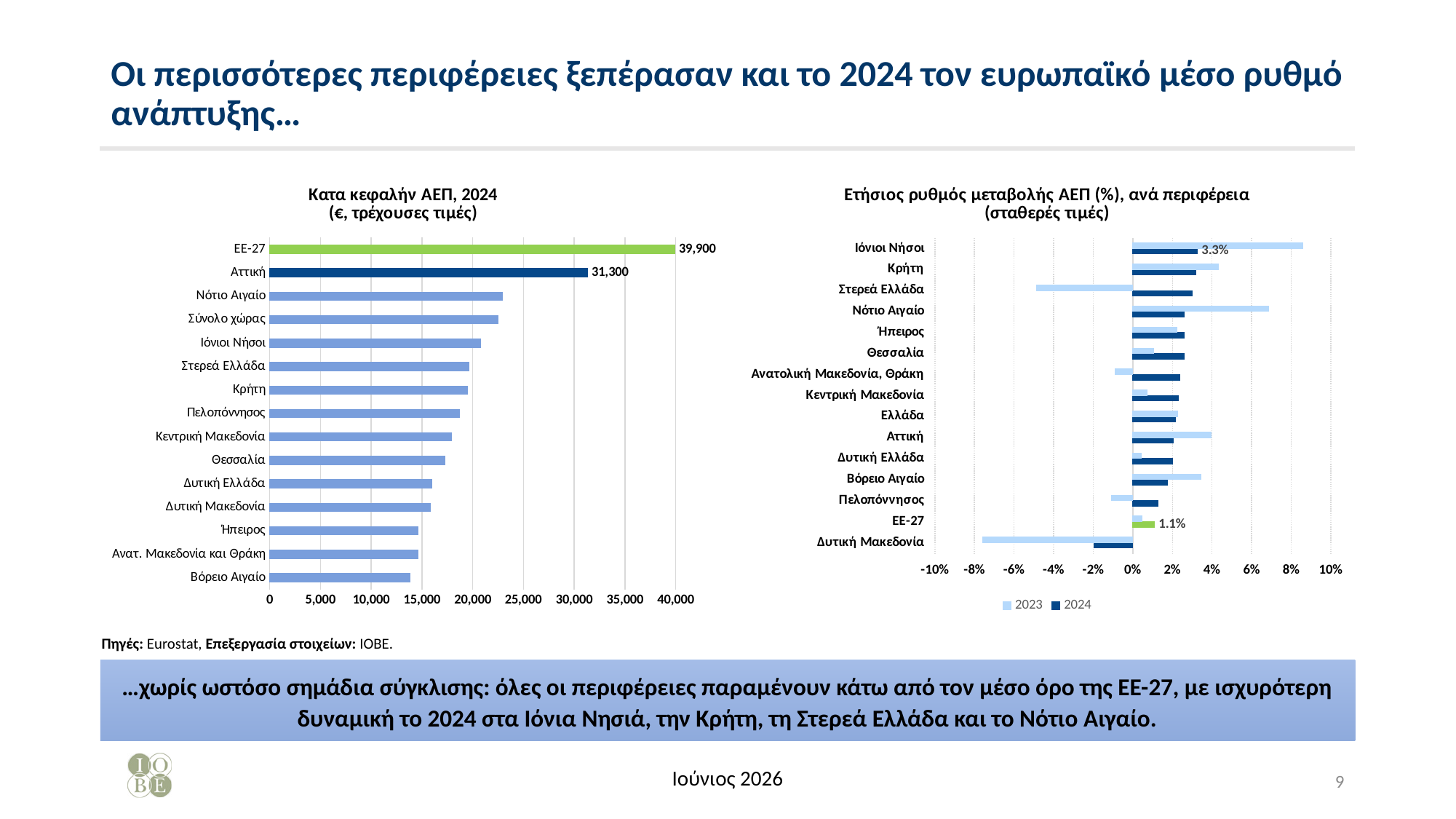
What kind of chart is the left chart (Κατα κεφαλήν ΑΕΠ, 2024)? bar chart How many categories are shown in the left chart (Κατα κεφαλήν ΑΕΠ, 2024)? 15 In the left chart (Κατα κεφαλήν ΑΕΠ, 2024), what is the value for Αττική? 31,300 How many series does the legend of the right chart (Ετήσιος ρυθμός μεταβολής ΑΕΠ) list? 2 In the left chart (Κατα κεφαλήν ΑΕΠ, 2024), what is the value for ΕΕ-27? 39,900 In the right chart (Ετήσιος ρυθμός μεταβολής ΑΕΠ), is the 2023 value for Δυτική Μακεδονία greater or less than -6%? less In the left chart (Κατα κεφαλήν ΑΕΠ, 2024), which category has the lowest value? Βόρειο Αιγαίο In the left chart (Κατα κεφαλήν ΑΕΠ, 2024), which category has the highest value? ΕΕ-27 In the right chart (Ετήσιος ρυθμός μεταβολής ΑΕΠ), what is the 2024 value for ΕΕ-27? 1.1% In the right chart (Ετήσιος ρυθμός μεταβολής ΑΕΠ), what is the 2024 value for Ιόνιοι Νήσοι? 3.3% In the left chart (Κατα κεφαλήν ΑΕΠ, 2024), what is the difference between the ΕΕ-27 value and the Αττική value? 8,600 In the left chart (Κατα κεφαλήν ΑΕΠ, 2024), is the value for Νότιο Αιγαίο greater or less than 20,000? greater